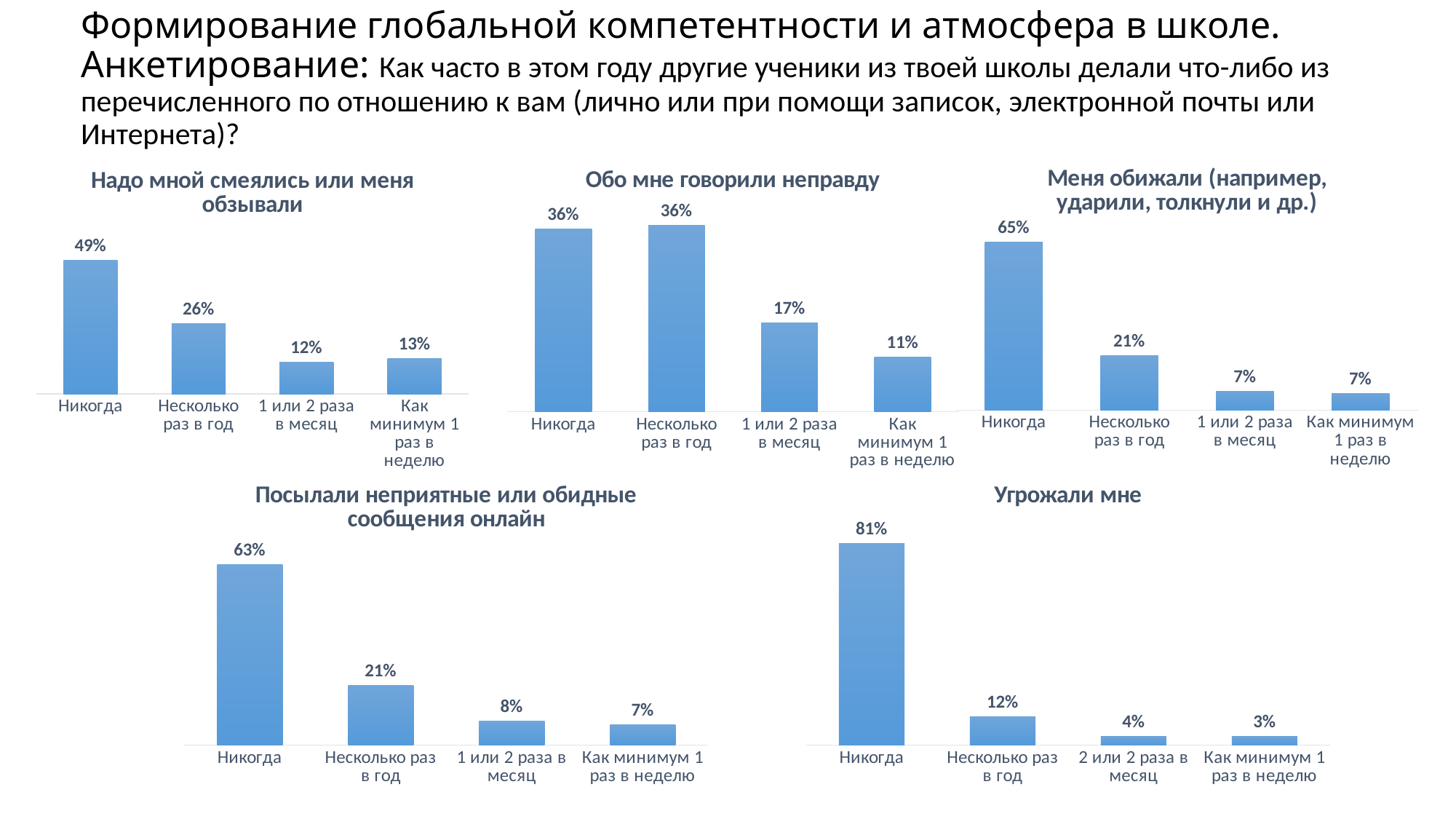
In the chart "Угрожали мне", what is the difference between "Никогда" and "Несколько раз в год"? 69% In the chart "Посылали неприятные или обидные сообщения онлайн", what is the value for "Никогда"? 63% In the chart "Угрожали мне", what is the value for "Никогда"? 81% In the chart "Меня обижали (например, ударили, толкнули и др.)", which category has the highest value? Никогда In the chart "Меня обижали (например, ударили, толкнули и др.)", what is the value for "Несколько раз в год"? 21% In the chart "Обо мне говорили неправду", what is the value for "1 или 2 раза в месяц"? 17% In the chart "Надо мной смеялись или меня обзывали", what is the value for "Никогда"? 49% In the chart "Надо мной смеялись или меня обзывали", which is larger: "1 или 2 раза в месяц" or "Как минимум 1 раз в неделю"? Как минимум 1 раз в неделю How many categories are shown in the chart "Угрожали мне"? 4 In the chart "Посылали неприятные или обидные сообщения онлайн", which category has the lowest value? Как минимум 1 раз в неделю In the chart "Обо мне говорили неправду", what is the difference between "Несколько раз в год" and "Как минимум 1 раз в неделю"? 25% What type of chart is "Обо мне говорили неправду"? Bar chart